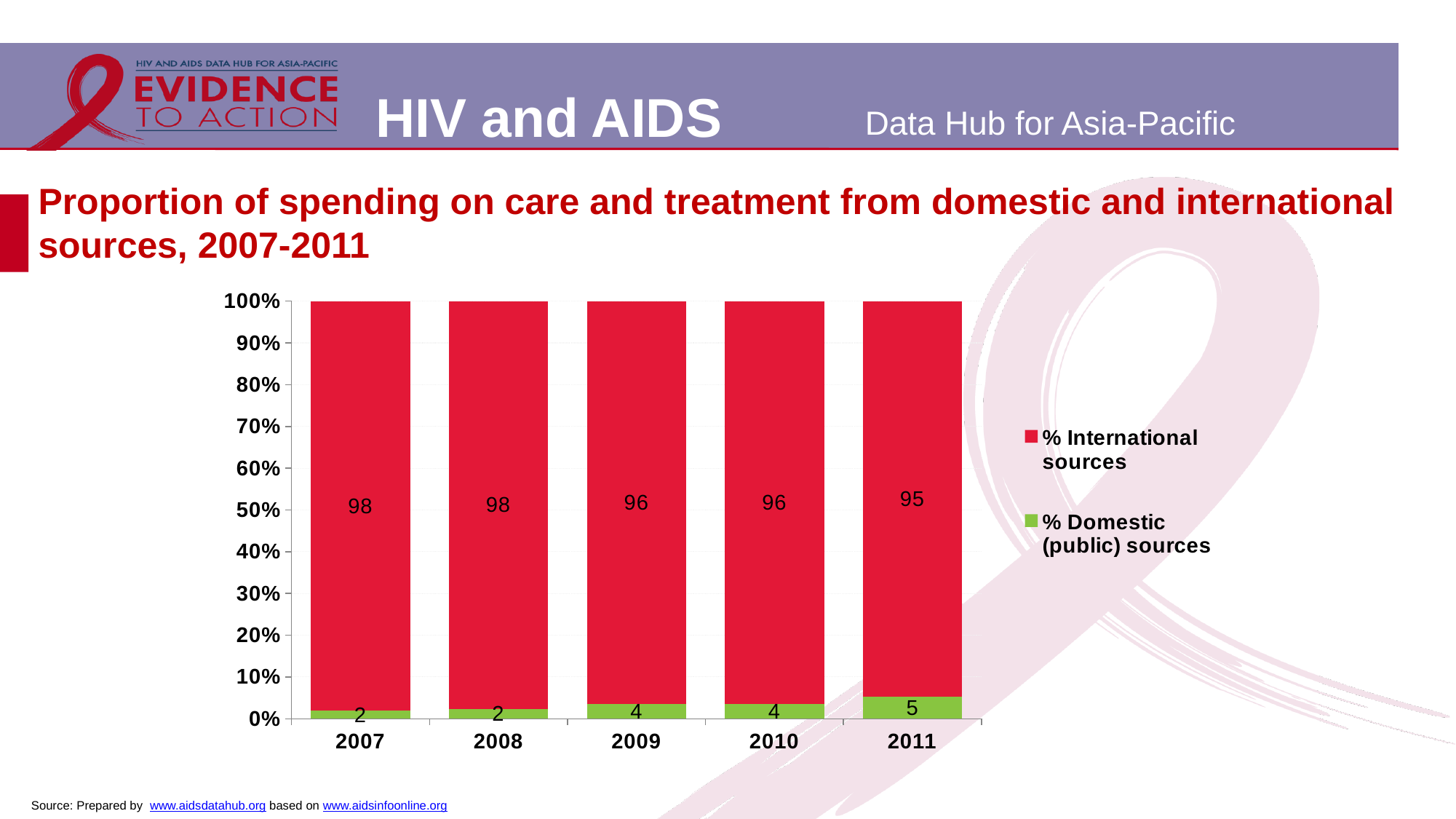
How many years are shown on the x axis? 5 Which is larger, the % Domestic (public) sources value for 2008 or for 2010? 2010 What is the difference between the % International sources values for 2007 and 2011? 3 In which year is the % Domestic (public) sources value highest? 2011 What kind of chart is shown on the slide? Stacked bar chart In which year is the % International sources value lowest? 2011 How many series does the legend list? 2 What is the value for % Domestic (public) sources in 2009? 4 Does the % Domestic (public) sources value rise or fall from 2007 to 2011? Rise What is the value for % International sources in 2007? 98 What is the value for % International sources in 2011? 95 What is the value for % Domestic (public) sources in 2011? 5